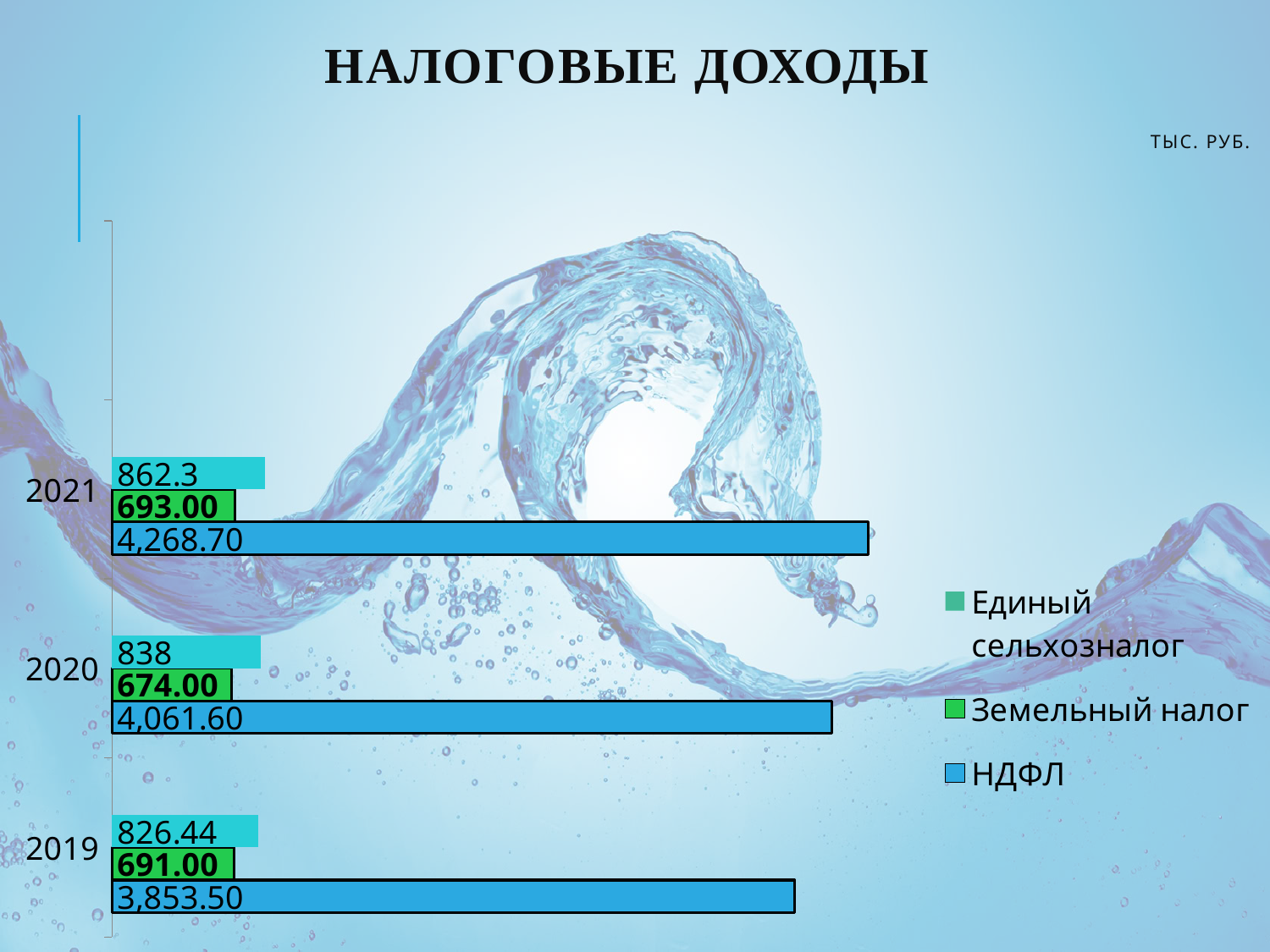
What is the value of Единый сельхозналог for 2020? 838 How many series does the legend list? 3 In which year is НДФЛ the highest? 2021 Which is larger: Земельный налог in 2019 or Земельный налог in 2021? Земельный налог in 2021 In which year is Земельный налог the lowest? 2020 What is the value of Единый сельхозналог for 2019? 826.44 What is the value of НДФЛ for 2021? 4,268.70 What is the difference between НДФЛ in 2021 and НДФЛ in 2019? 415.20 What kind of chart is shown on the slide? Bar chart How many years are shown on the chart? 3 What is the title of the chart? НАЛОГОВЫЕ ДОХОДЫ What is the value of Земельный налог for 2020? 674.00